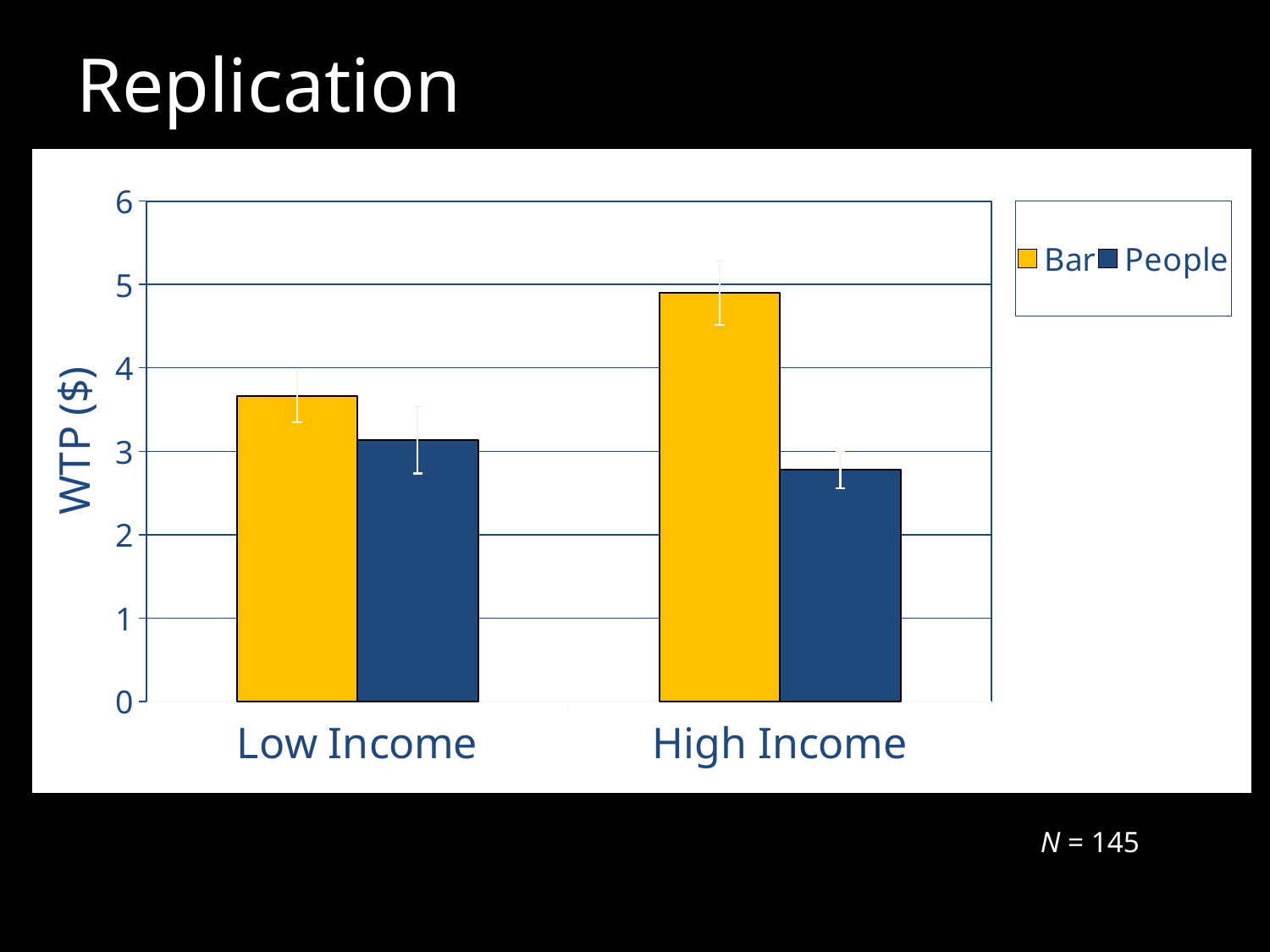
Is the value for People in the High Income category greater or less than 3? less How many series does the legend list? 2 What is the label of the y axis? WTP ($) What kind of chart is shown on the slide? bar chart For Low Income, which series has the larger value, Bar or People? Bar For the Bar series, which category has the larger value, Low Income or High Income? High Income How many income categories are shown on the x axis? 2 Is the value for Bar in the High Income category greater or less than 4? greater Which bar is the tallest in the chart? Bar, High Income For High Income, which series has the larger value, Bar or People? Bar What are the two series named in the legend? Bar and People Which bar is the shortest in the chart? People, High Income